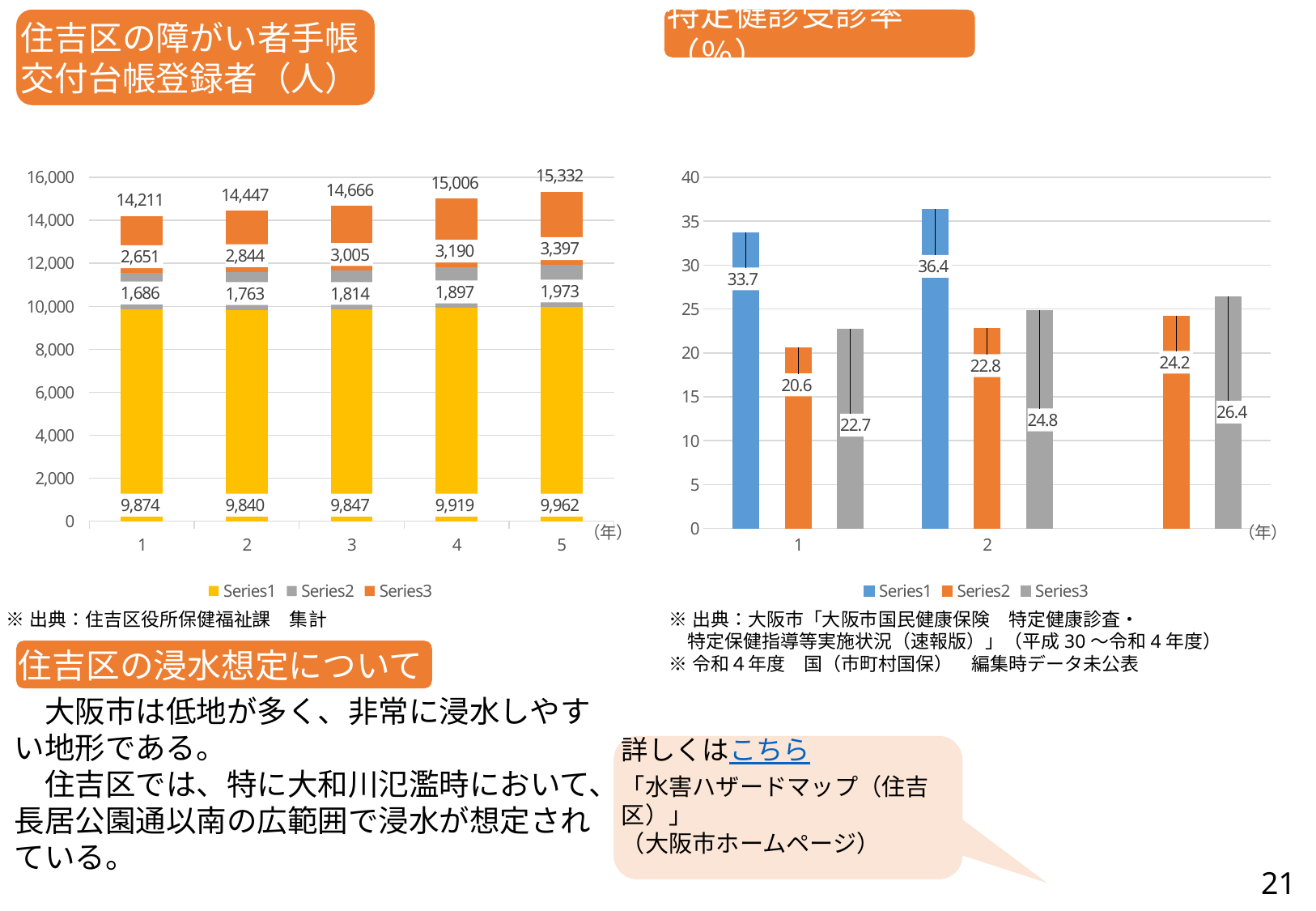
In the right chart (特定健診受診率), what is the Series3 value for year 2? 24.8 In the left chart (住吉区の障がい者手帳交付台帳登録者), what is the difference between the total for year 5 and the total for year 1? 1,121 What kind of chart is the left chart (住吉区の障がい者手帳交付台帳登録者)? Stacked bar chart In the right chart (特定健診受診率), what is the Series1 value for year 1? 33.7 In the left chart (住吉区の障がい者手帳交付台帳登録者), what is the Series1 value for year 2? 9,840 In the left chart (住吉区の障がい者手帳交付台帳登録者), which year has the highest total? 5 In the left chart (住吉区の障がい者手帳交付台帳登録者), what is the Series2 value for year 3? 1,814 In the left chart (住吉区の障がい者手帳交付台帳登録者), do the totals rise or fall from year 1 to year 5? Rise In the left chart (住吉区の障がい者手帳交付台帳登録者), how many years are shown on the x axis? 5 In the right chart (特定健診受診率), how many series does the legend list? 3 In the left chart (住吉区の障がい者手帳交付台帳登録者), what is the Series3 value for year 4? 3,190 In the left chart (住吉区の障がい者手帳交付台帳登録者), what is the total for year 5? 15,332